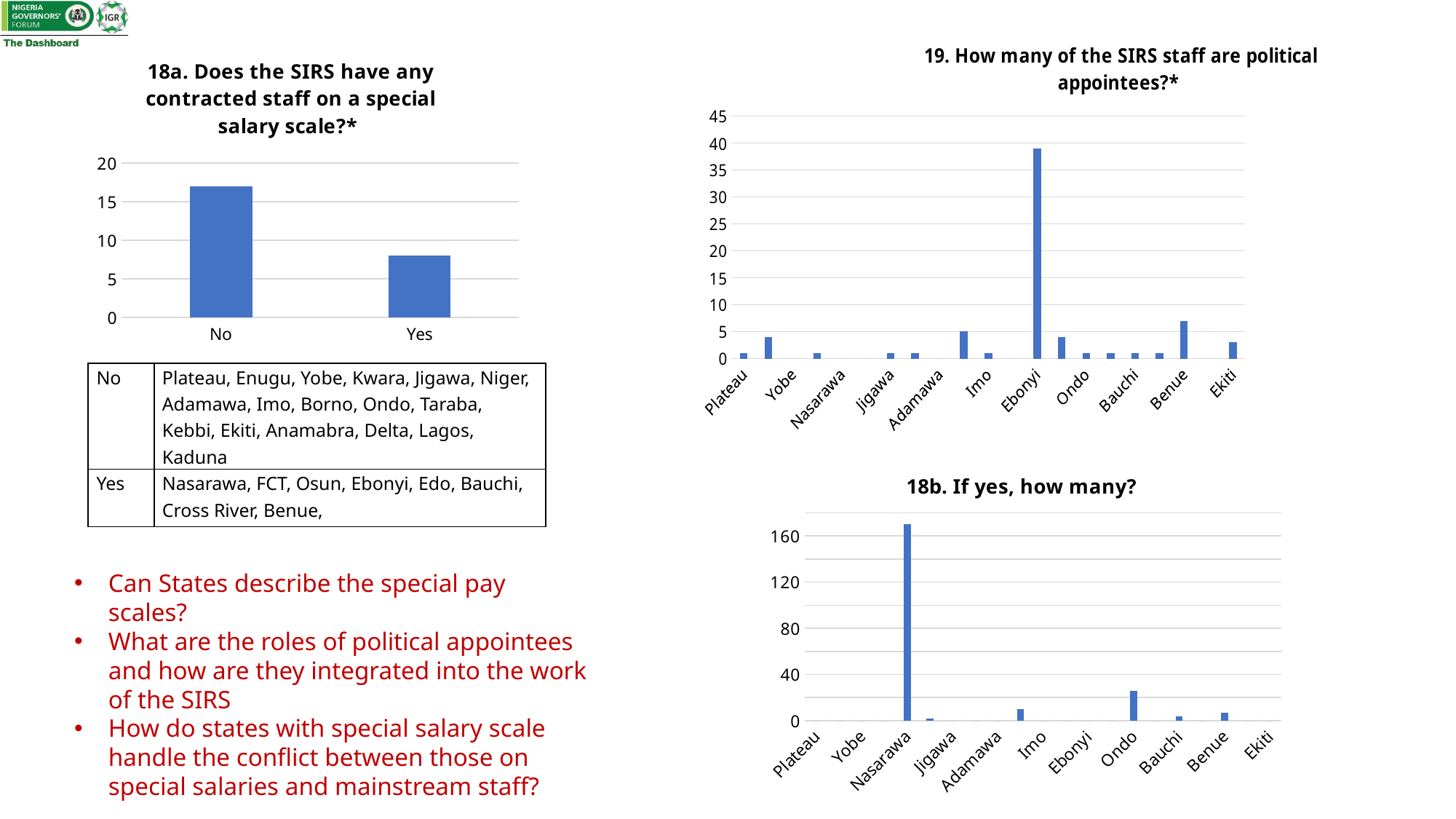
In the chart titled '18a. Does the SIRS have any contracted staff on a special salary scale?*', which category has the taller bar, No or Yes? No In the chart titled '18b. If yes, how many?', is the value for Ondo greater or less than 40? less In the chart titled '18a. Does the SIRS have any contracted staff on a special salary scale?*', is the value for Yes greater or less than 10? less In the chart titled '18b. If yes, how many?', which has the larger value, Nasarawa or Ondo? Nasarawa In the chart titled '18b. If yes, how many?', which state has the highest value? Nasarawa In the chart titled '19. How many of the SIRS staff are political appointees?*', which state has the highest value? Ebonyi In the chart titled '19. How many of the SIRS staff are political appointees?*', which has the larger value, Ebonyi or Benue? Ebonyi In the chart titled '18a. Does the SIRS have any contracted staff on a special salary scale?*', is the value for No greater or less than 15? greater What kind of chart is the one titled '18a. Does the SIRS have any contracted staff on a special salary scale?*'? Bar chart